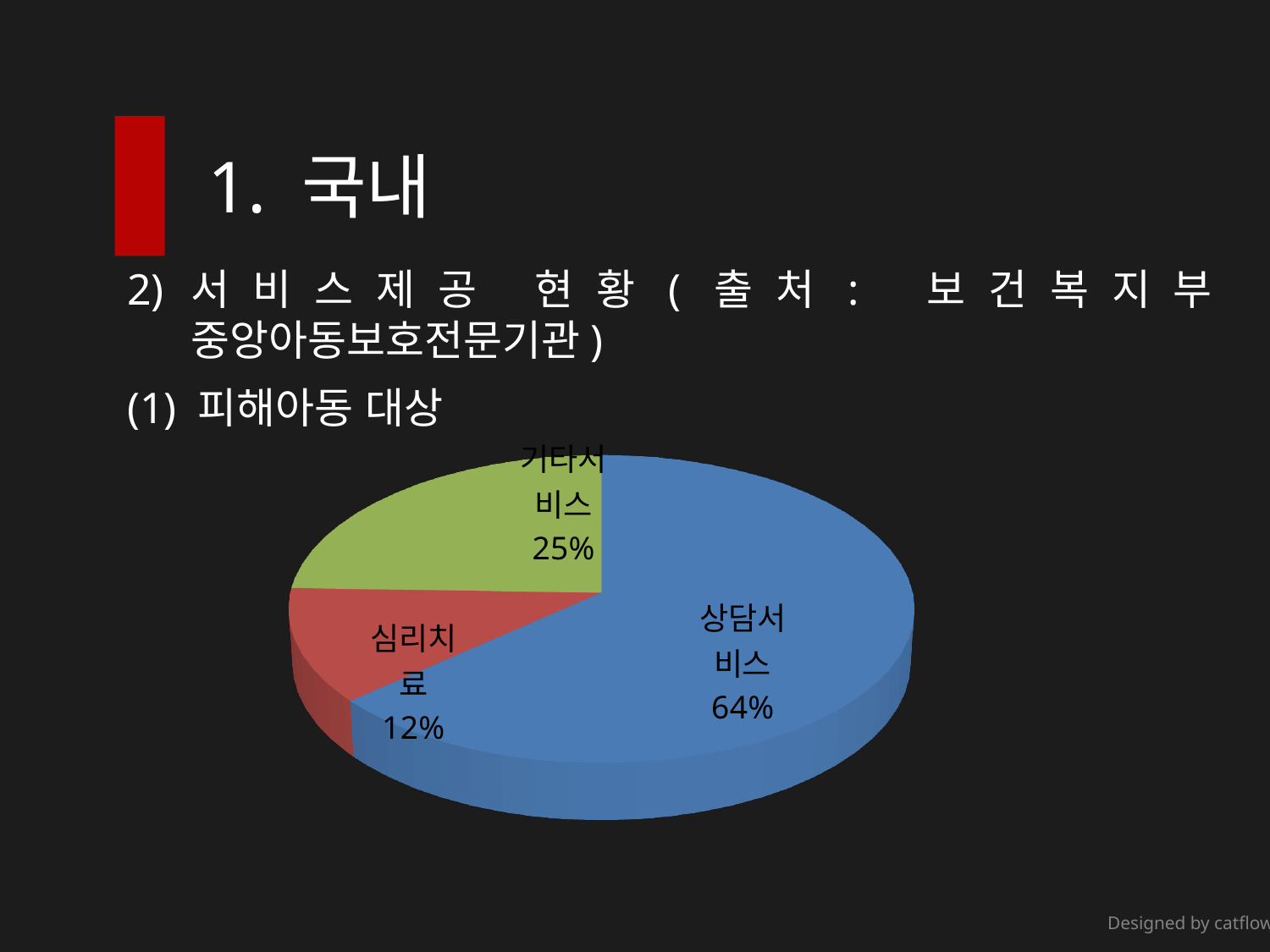
How many categories are shown in the pie chart? 3 Which category has the smallest slice of the pie? 심리치료 What colour is the 상담서비스 slice? Blue What is the difference in percentage points between 기타서비스 and 심리치료? 13% Which is larger, the share for 심리치료 or the share for 기타서비스? 기타서비스 What kind of chart is shown on the slide? Pie chart Which category has the largest slice of the pie? 상담서비스 What share of the pie does 상담서비스 represent? 64% What is the difference in percentage points between 상담서비스 and 기타서비스? 39% What colour is the 심리치료 slice? Red What share of the pie does 심리치료 represent? 12% What share of the pie does 기타서비스 represent? 25%